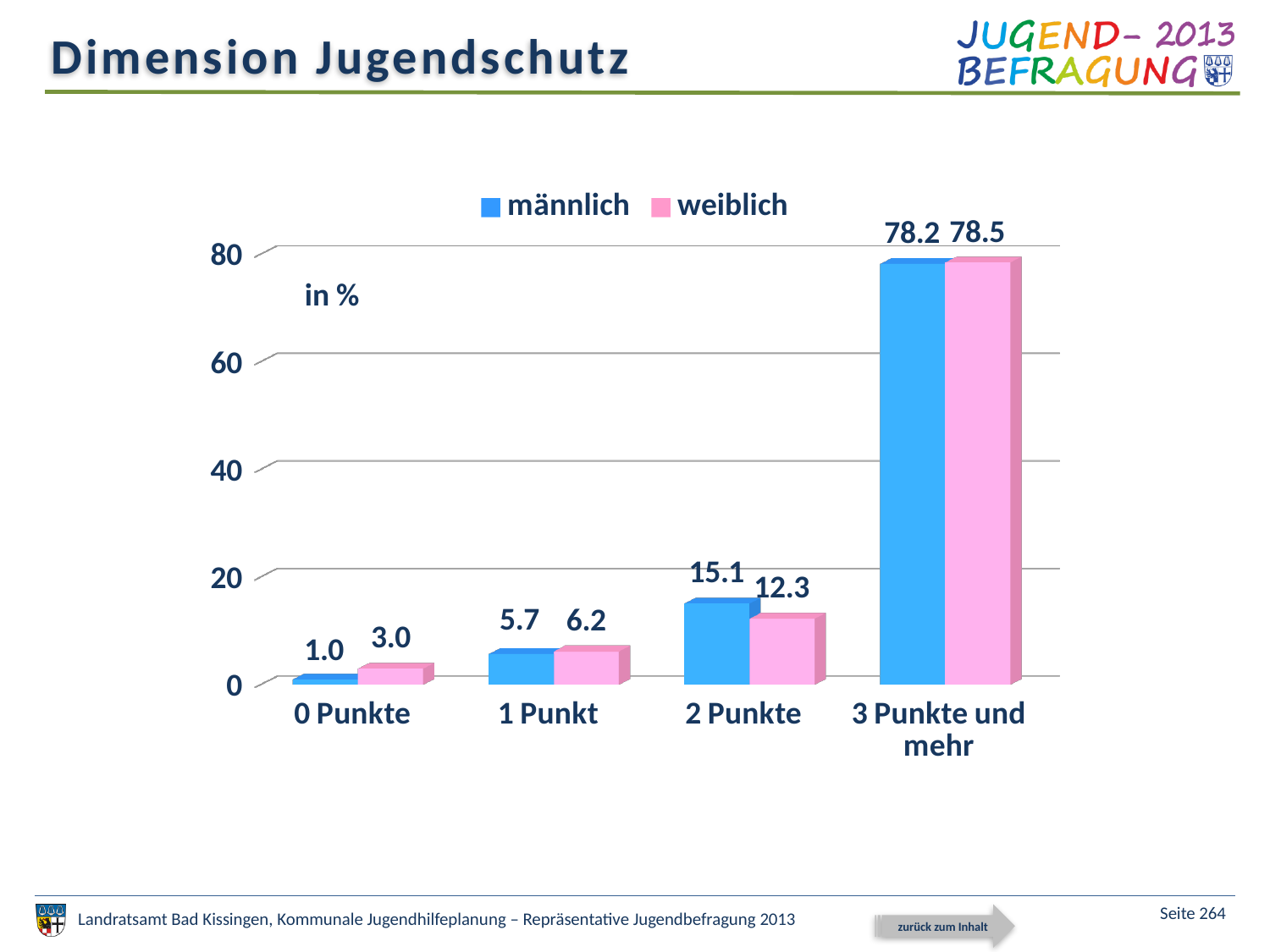
What is the value for weiblich in the 2 Punkte category? 12.3 How many categories are shown on the x axis? 4 What kind of chart is shown on the slide? bar chart How many series does the legend list? 2 What is the value for männlich in the 0 Punkte category? 1.0 In the 1 Punkt category, which is larger: männlich or weiblich? weiblich Which colour represents the weiblich series? pink Which category has the highest value for männlich? 3 Punkte und mehr What is the difference between männlich and weiblich in the 2 Punkte category? 2.8 Is the value for männlich in the 3 Punkte und mehr category greater or less than 60? greater What is the value for weiblich in the 3 Punkte und mehr category? 78.5 Which category has the lowest value for weiblich? 0 Punkte